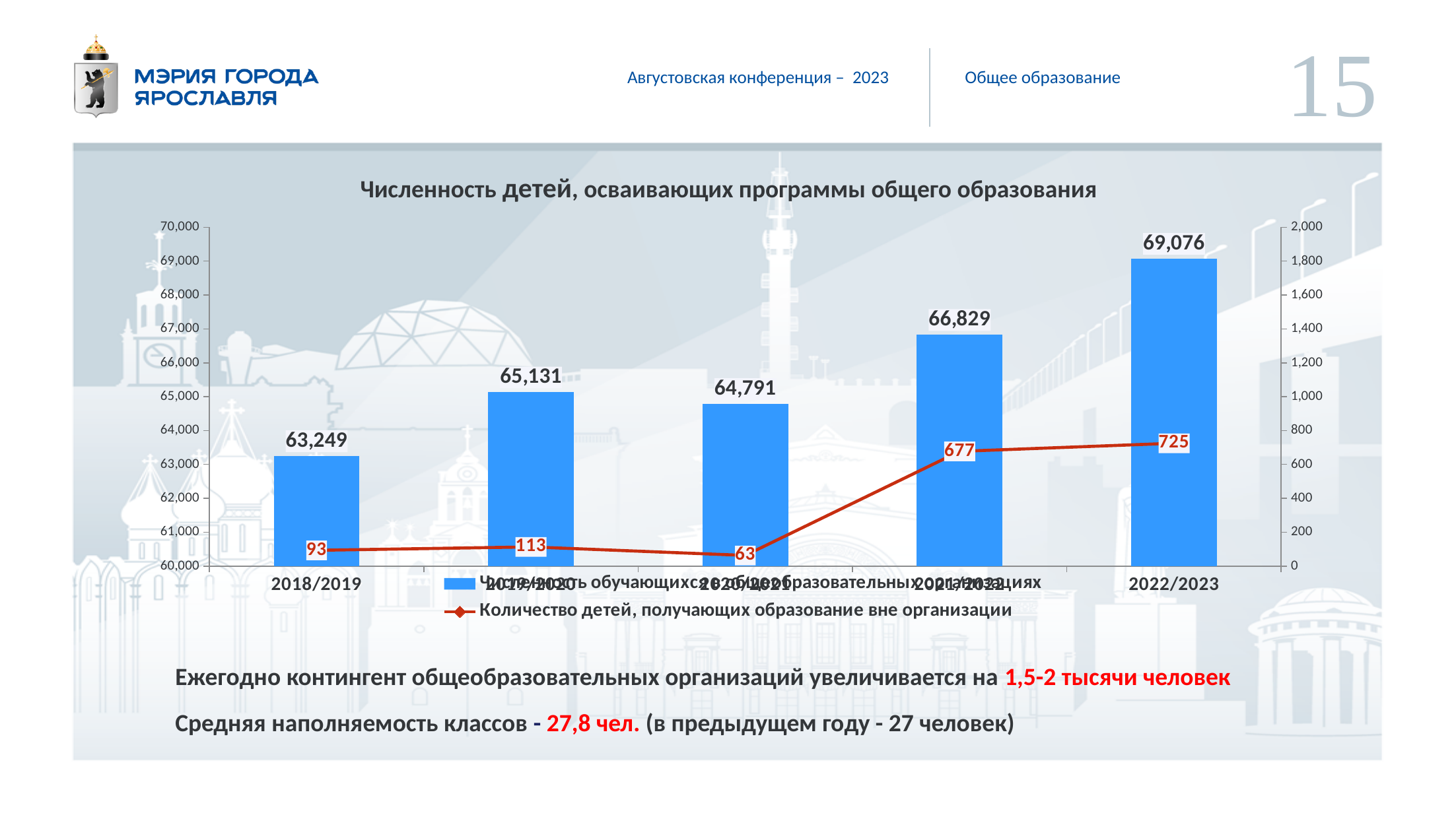
What is the value of the bar for 2018/2019? 63,249 What is the title of the chart? Численность детей, осваивающих программы общего образования What is the value of the line series for 2020/2021? 63 How many series does the legend list? 2 How many school years are shown on the x axis? 5 In which school year is the number of children receiving education outside organizations lowest? 2020/2021 What is the number of children receiving education outside organizations in 2021/2022? 677 What is the difference between the line values for 2022/2023 and 2021/2022? 48 In which school year is the number of students in general education organizations highest? 2022/2023 Which year has a larger bar value, 2019/2020 or 2020/2021? 2019/2020 By how much did the number of students in general education organizations increase from 2021/2022 to 2022/2023? 2,247 What is the number of students in general education organizations in 2022/2023? 69,076